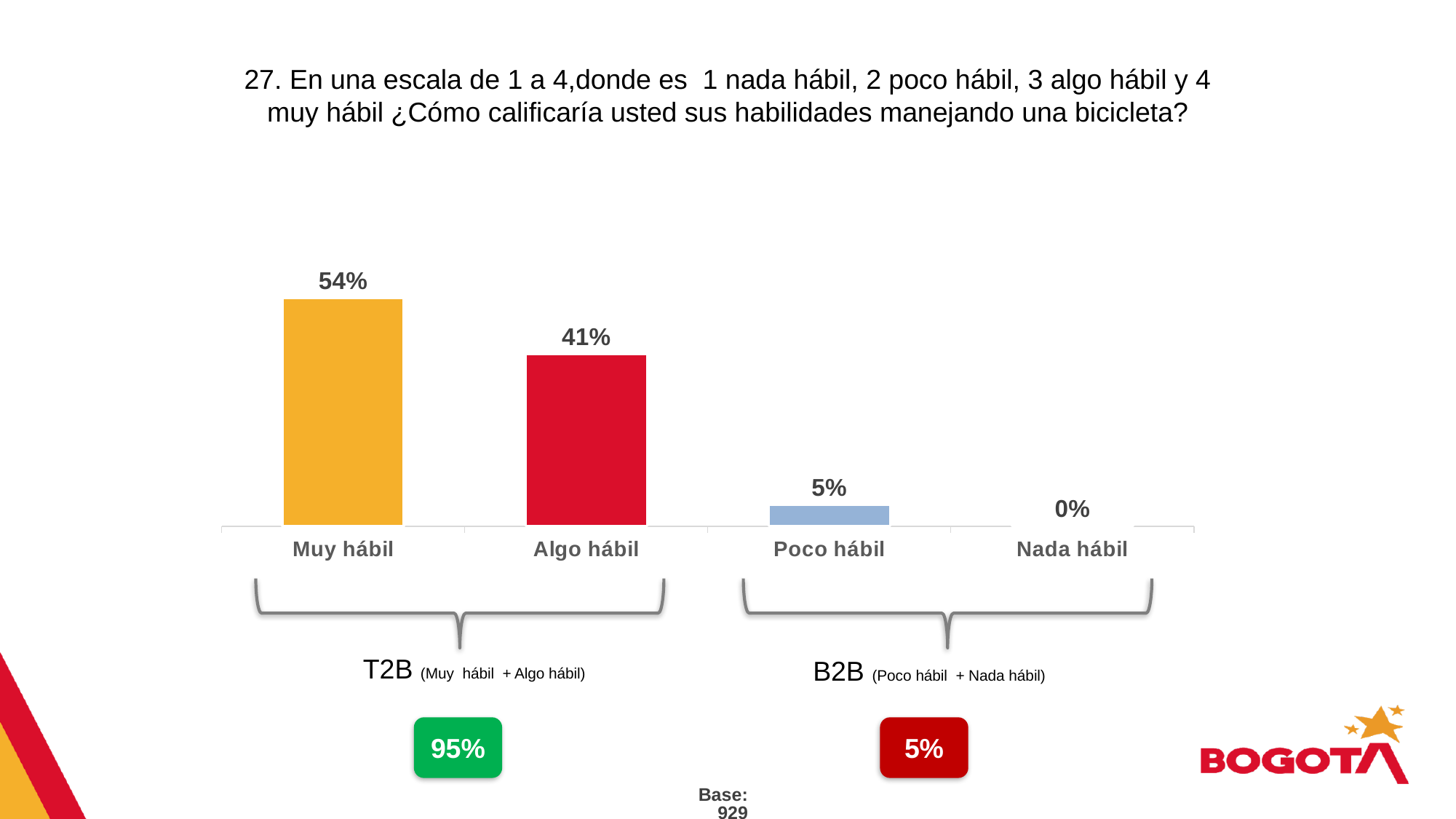
Which is larger, the value for Algo hábil or the value for Poco hábil? Algo hábil What is the value for Algo hábil? 41% Which category has the highest value? Muy hábil What is the difference between the values for Muy hábil and Algo hábil? 13% What kind of chart is shown on the slide? Bar chart What colour is the bar for Muy hábil? Orange What is the value for Nada hábil? 0% What is the value for Poco hábil? 5% Which category has the lowest value? Nada hábil How many categories are shown on the chart? 4 What is the value for Muy hábil? 54% What is the T2B (Muy hábil + Algo hábil) value shown on the slide? 95%